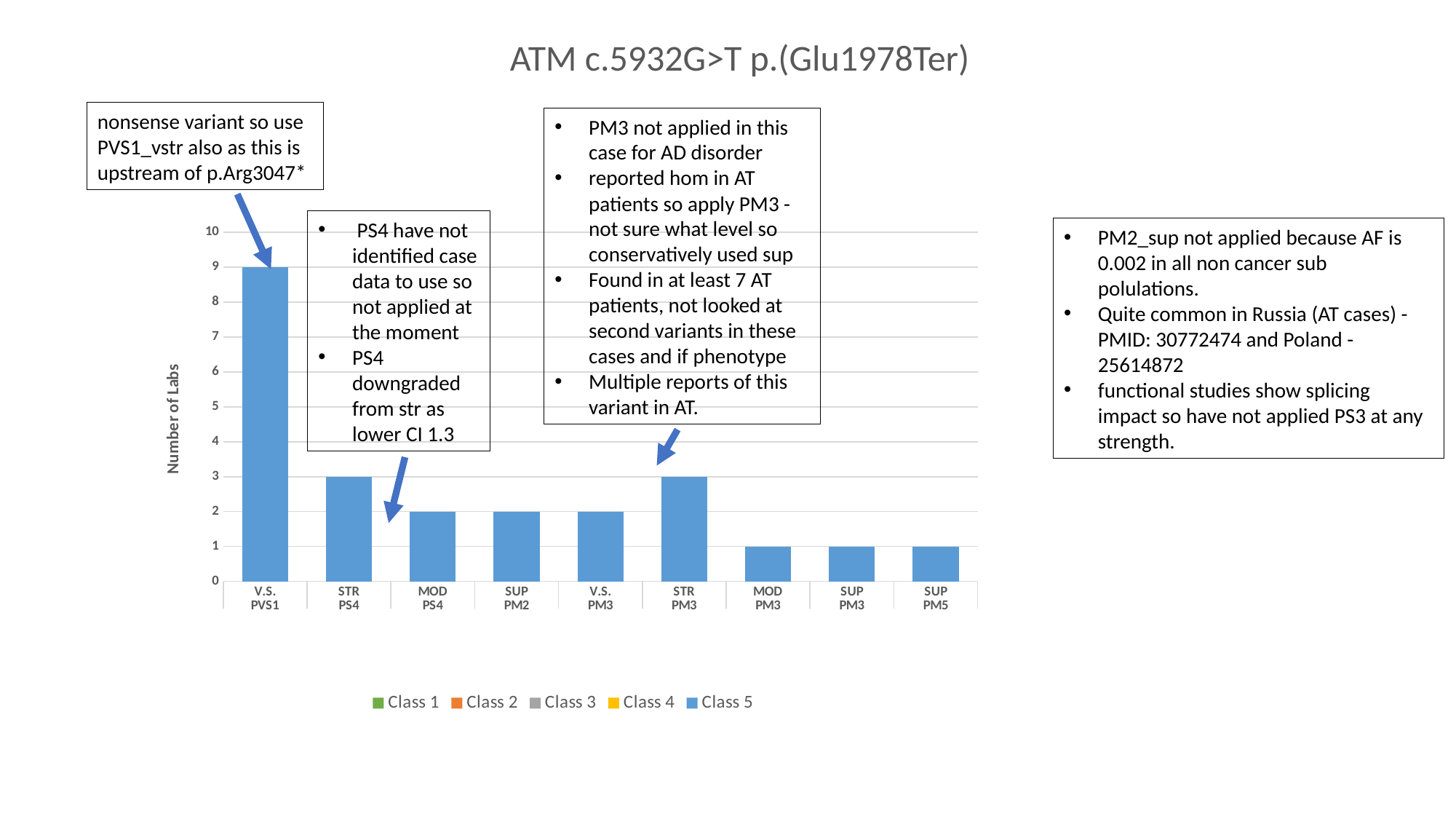
Which is larger, the number of labs for STR PS4 or for MOD PS4? STR PS4 What is the difference in number of labs between V.S. PVS1 and STR PS4? 6 How many series does the legend list? 5 What is the title of the chart? ATM c.5932G>T p.(Glu1978Ter) What kind of chart is shown on the slide? bar chart Which category has the highest number of labs? V.S. PVS1 What is the number of labs for STR PM3? 3 How many categories are shown on the x axis? 9 What is the label of the y axis? Number of Labs What is the number of labs for V.S. PVS1? 9 What is the number of labs for SUP PM5? 1 Is the value for V.S. PVS1 greater or less than 5? greater